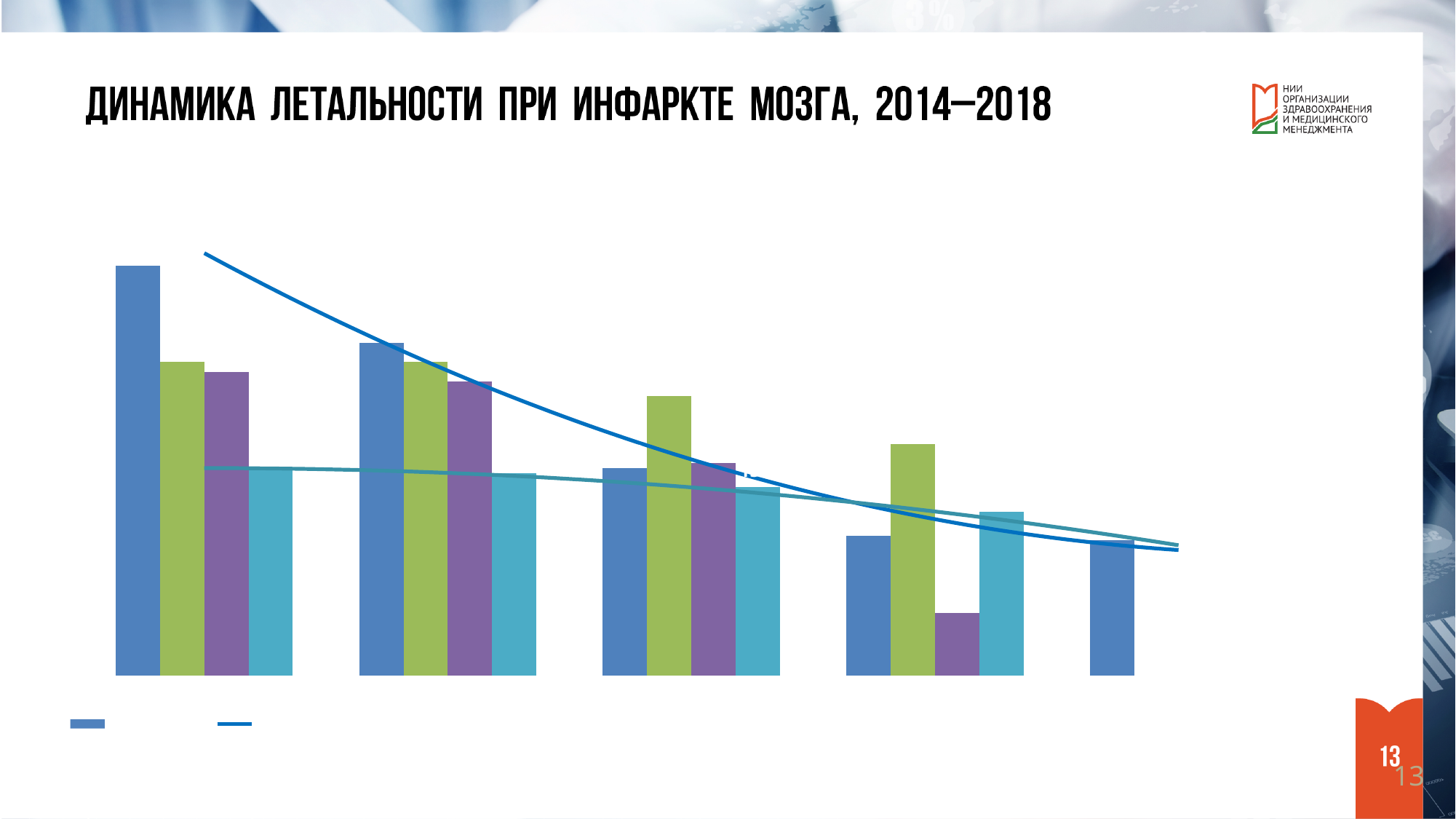
Does the dark blue trend line rise or fall from left to right? fall In the fourth group, which is taller: the green bar or the blue bar? the green bar How many trend lines are drawn over the bars? 2 How many groups of bars are plotted along the x axis? 5 How many bars are in the rightmost (fifth) group? 1 What kind of chart is shown on the slide? bar chart Do the blue bars rise or fall from left to right along the x axis? fall In the first group, which is taller: the blue bar or the green bar? the blue bar Which group has the tallest blue bar? the first (leftmost) group Which group has the shortest purple bar? the fourth group What is the title of the chart on the slide? ДИНАМИКА ЛЕТАЛЬНОСТИ ПРИ ИНФАРКТЕ МОЗГА, 2014–2018 How many different bar colours (bar series) are plotted in the chart? 4